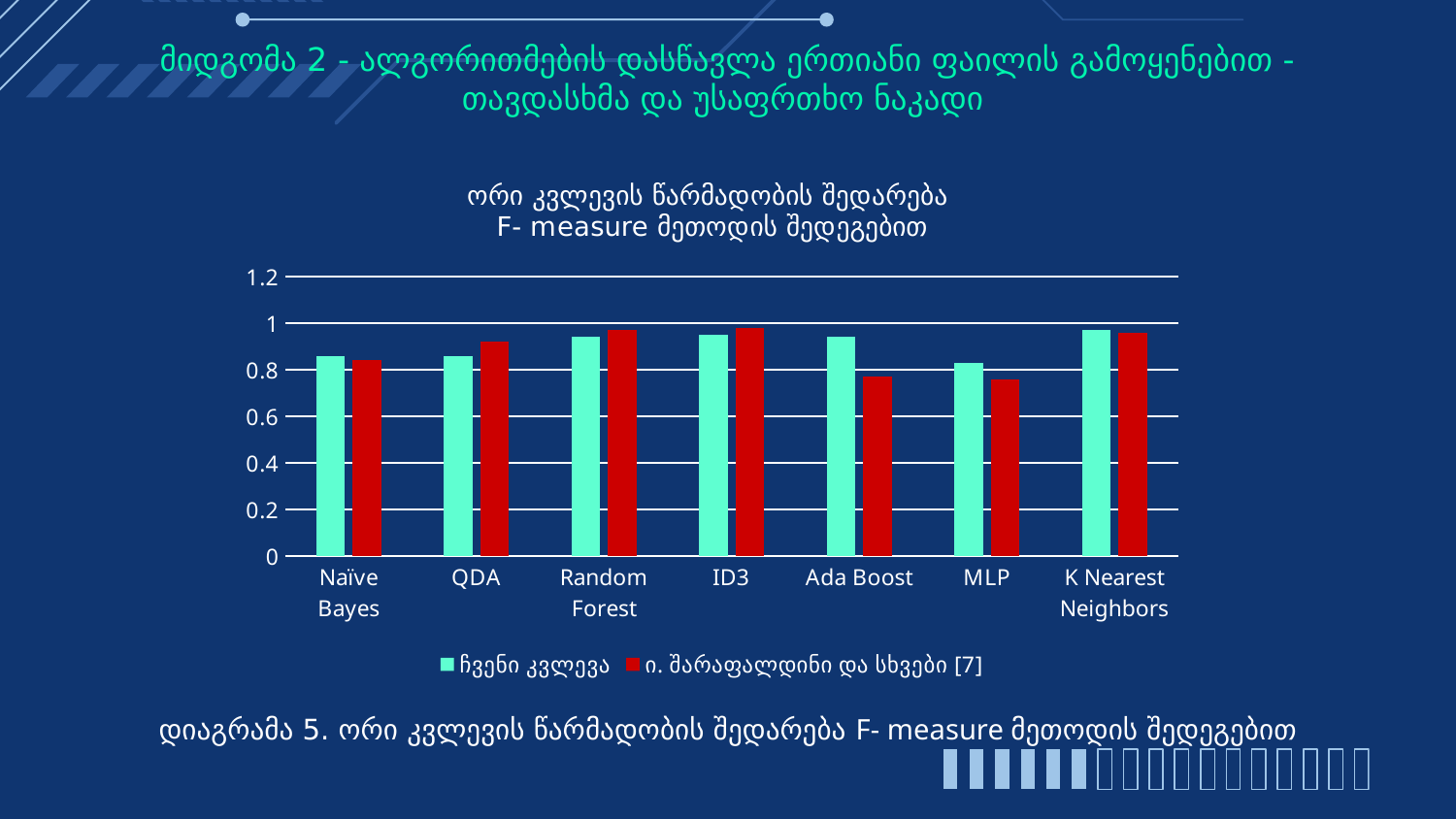
Is the value for Ada Boost in the 'ი. შარაფალდინი და სხვები [7]' series greater or less than 0.8? less Is the value for MLP in the 'ი. შარაფალდინი და სხვები [7]' series greater or less than 0.8? less For QDA, which series has the larger value: 'ჩვენი კვლევა' or 'ი. შარაფალდინი და სხვები [7]'? ი. შარაფალდინი და სხვები [7] Which colour represents the 'ჩვენი კვლევა' series in the chart? teal (light green) How many series does the chart's legend list? 2 In the 'ჩვენი კვლევა' series, which has the larger value: Ada Boost or MLP? Ada Boost In the 'ი. შარაფალდინი და სხვები [7]' series, which has the larger value: Random Forest or Ada Boost? Random Forest Is the value for ID3 in the 'ჩვენი კვლევა' series greater or less than 0.8? greater What kind of chart is shown on the slide? bar chart How many algorithm categories are shown on the x axis of the chart? 7